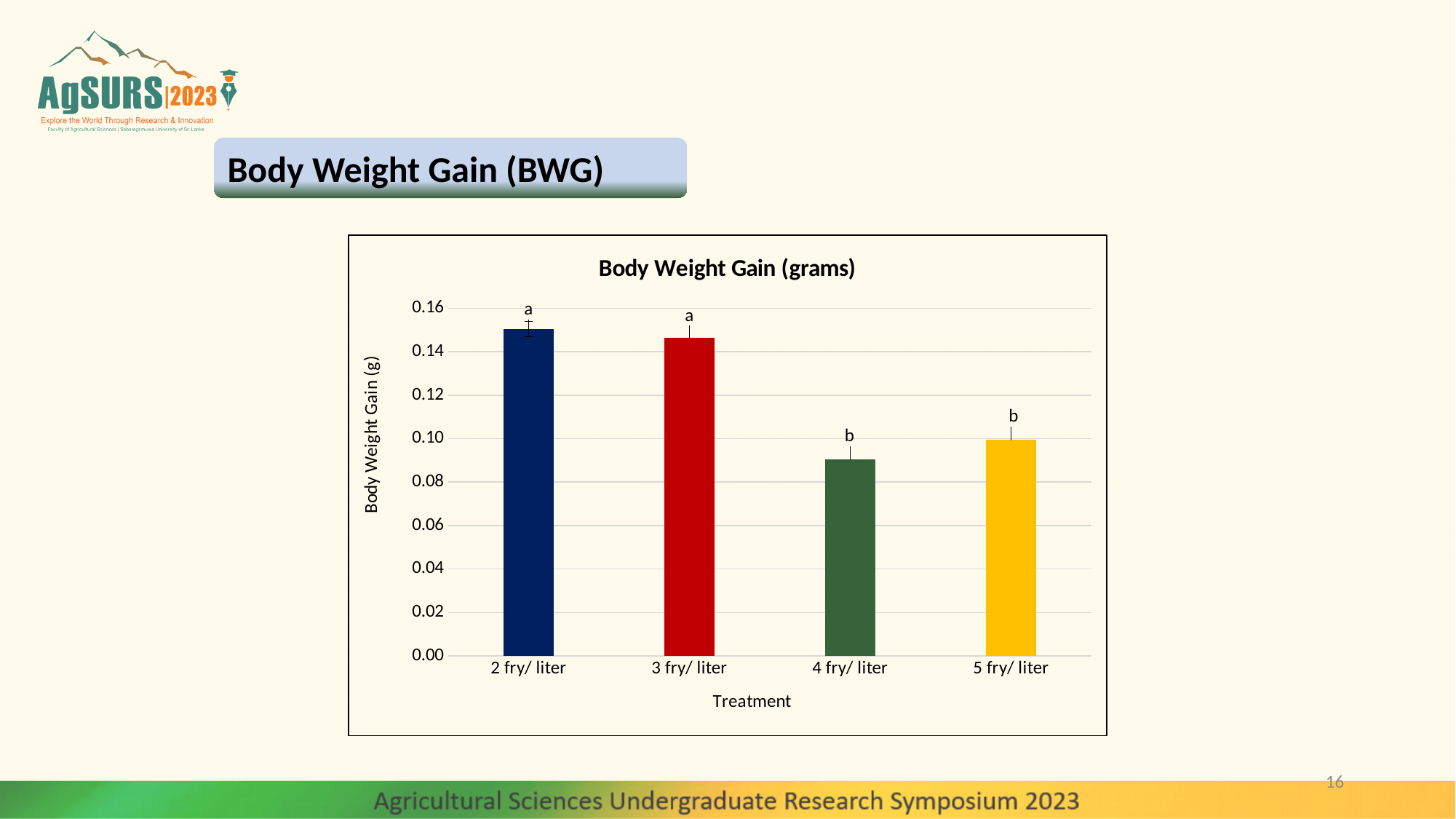
What is the title of the chart? Body Weight Gain (grams) What kind of chart is shown on the slide? bar chart Which has the larger body weight gain, 2 fry/ liter or 4 fry/ liter? 2 fry/ liter What is the label of the y axis? Body Weight Gain (g) Is the body weight gain for 5 fry/ liter greater or less than 0.08? greater Is the body weight gain for 2 fry/ liter greater or less than 0.14? greater Is the body weight gain for 4 fry/ liter greater or less than 0.10? less Which treatment has the lowest body weight gain? 4 fry/ liter Does the body weight gain rise or fall from 3 fry/ liter to 4 fry/ liter? fall Which has the larger body weight gain, 3 fry/ liter or 5 fry/ liter? 3 fry/ liter How many treatment categories are plotted on the x axis? 4